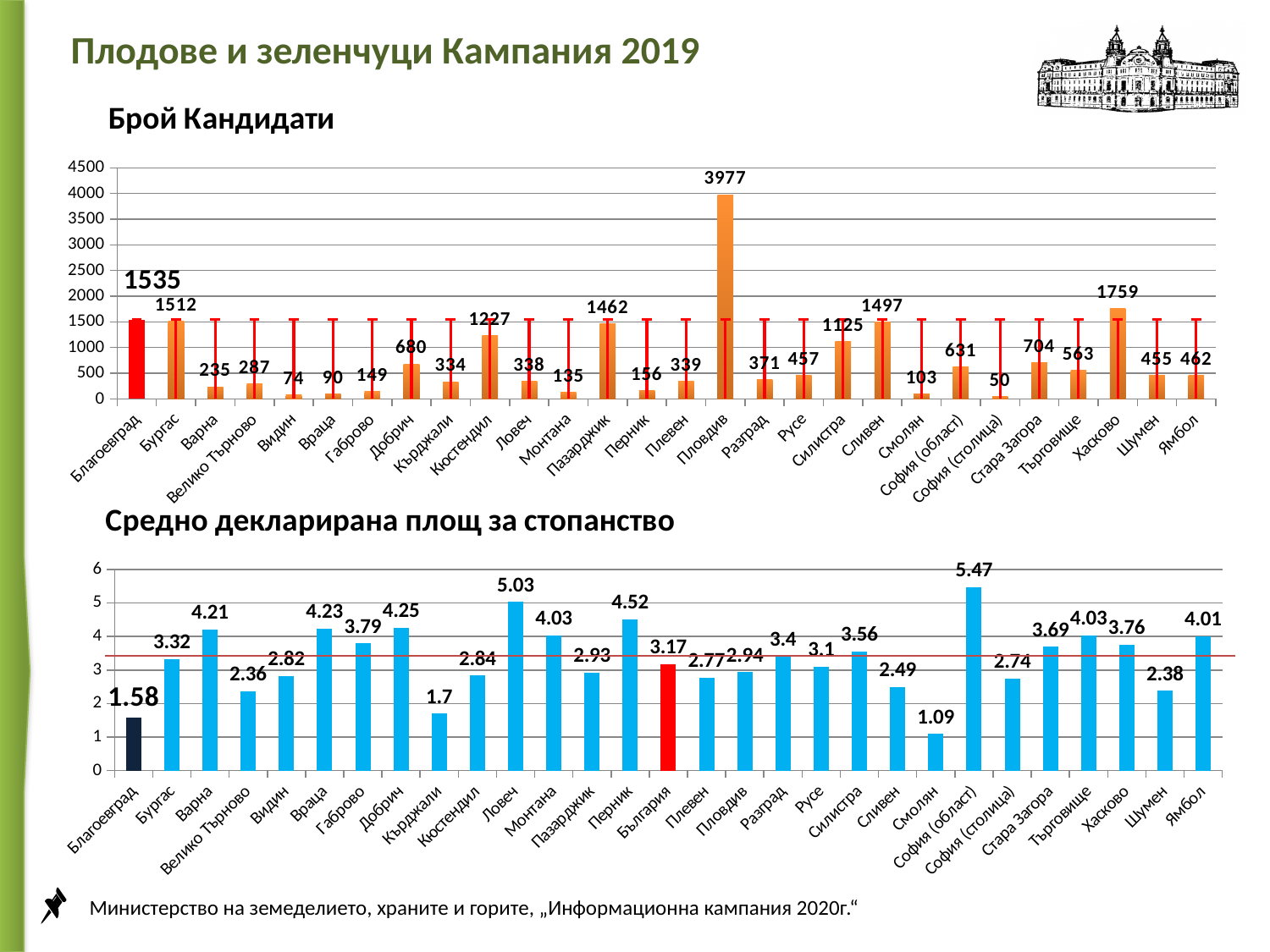
In the 'Средно декларирана площ за стопанство' chart, what is the value for България? 3.17 How many categories are shown in the 'Средно декларирана площ за стопанство' chart? 29 In the 'Средно декларирана площ за стопанство' chart, what is the difference between the values for Ловеч and Благоевград? 3.45 In the 'Брой Кандидати' chart, what is the value for Пловдив? 3977 In the 'Средно декларирана площ за стопанство' chart, which category has the lowest value? Смолян In the 'Брой Кандидати' chart, which is larger, the value for Кюстендил or the value for Силистра? Кюстендил In the 'Брой Кандидати' chart, what is the difference between the values for Хасково and Бургас? 247 In the 'Брой Кандидати' chart, which category has the lowest value? София (столица) In the 'Средно декларирана площ за стопанство' chart, is the value for Перник greater or less than 4? greater What type of chart is the 'Брой Кандидати' chart? Bar chart In the 'Средно декларирана площ за стопанство' chart, which category has the highest value? София (област) In the 'Брой Кандидати' chart, what is the value for Стара Загора? 704